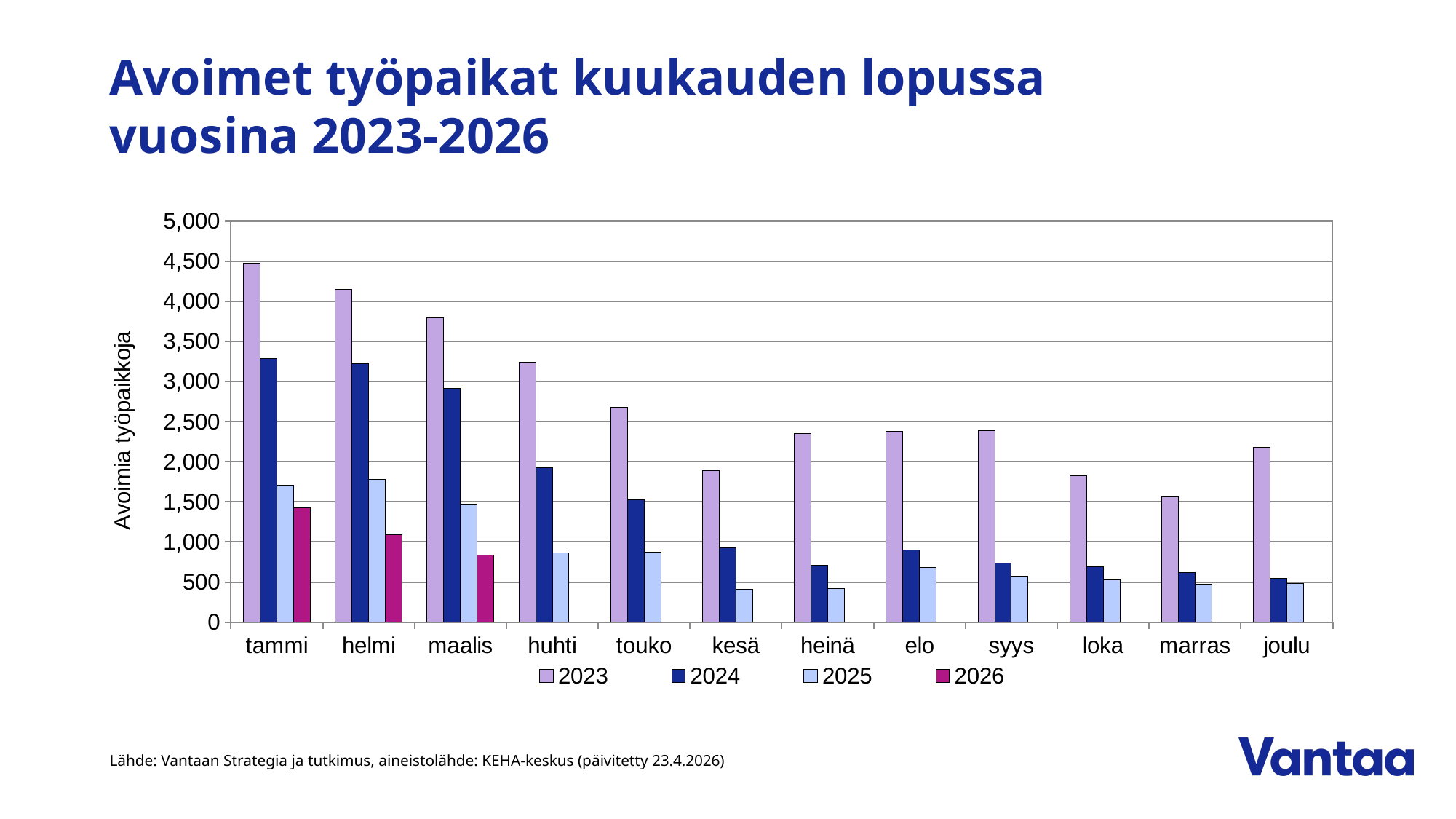
In which month is the 2023 value highest? tammi Is the 2024 value for tammi greater or less than 3,000? greater In which month is the 2023 value lowest? marras What kind of chart is shown on the slide? bar chart In tammi, which is larger: the 2024 value or the 2025 value? 2024 Is the 2023 value for tammi greater or less than 4,000? greater Is the 2025 value for kesä greater or less than 500? less In which month is the 2024 value lowest? joulu For how many months is a 2026 bar plotted? 3 How many months are shown on the x axis? 12 How many series does the legend list? 4